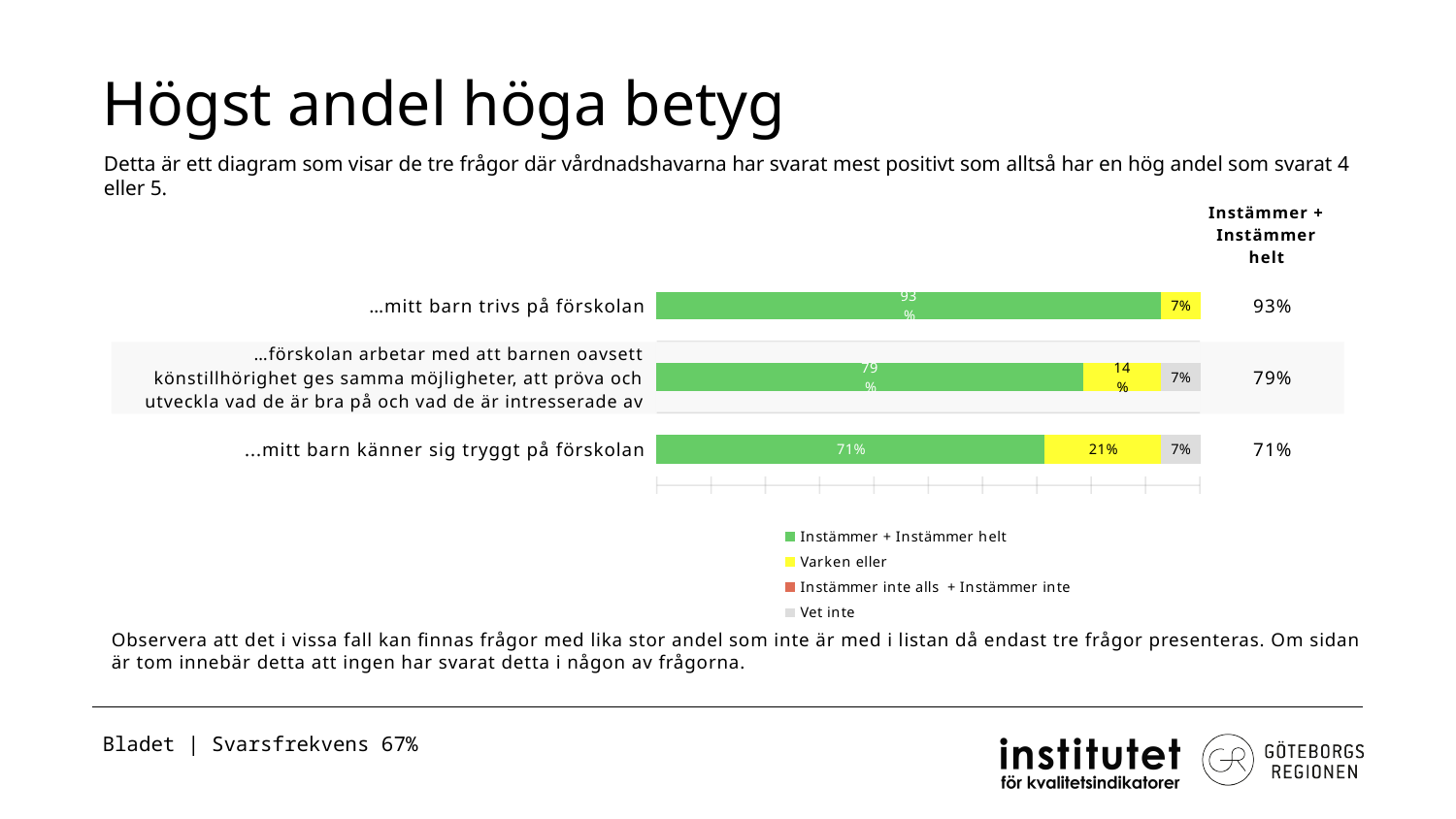
What is the "Varken eller" value for the question about "förskolan arbetar med att barnen oavsett könstillhörighet ges samma möjligheter"? 14% What is the "Varken eller" value for "...mitt barn känner sig tryggt på förskolan"? 21% What is the "Vet inte" value for "...mitt barn känner sig tryggt på förskolan"? 7% What is the "Instämmer + Instämmer helt" value for "…mitt barn trivs på förskolan"? 93% Which legend entry is shown in green? Instämmer + Instämmer helt Which has a larger "Varken eller" share: "...mitt barn känner sig tryggt på förskolan" or "…mitt barn trivs på förskolan"? ...mitt barn känner sig tryggt på förskolan Which question has the lowest "Instämmer + Instämmer helt" share? ...mitt barn känner sig tryggt på förskolan What kind of chart is shown on the slide? Stacked bar chart How many questions (categories) are shown in the chart? 3 What is the difference in "Instämmer + Instämmer helt" share between "…mitt barn trivs på förskolan" and "...mitt barn känner sig tryggt på förskolan"? 22% Which question has the highest "Instämmer + Instämmer helt" share? …mitt barn trivs på förskolan How many series does the legend list? 4